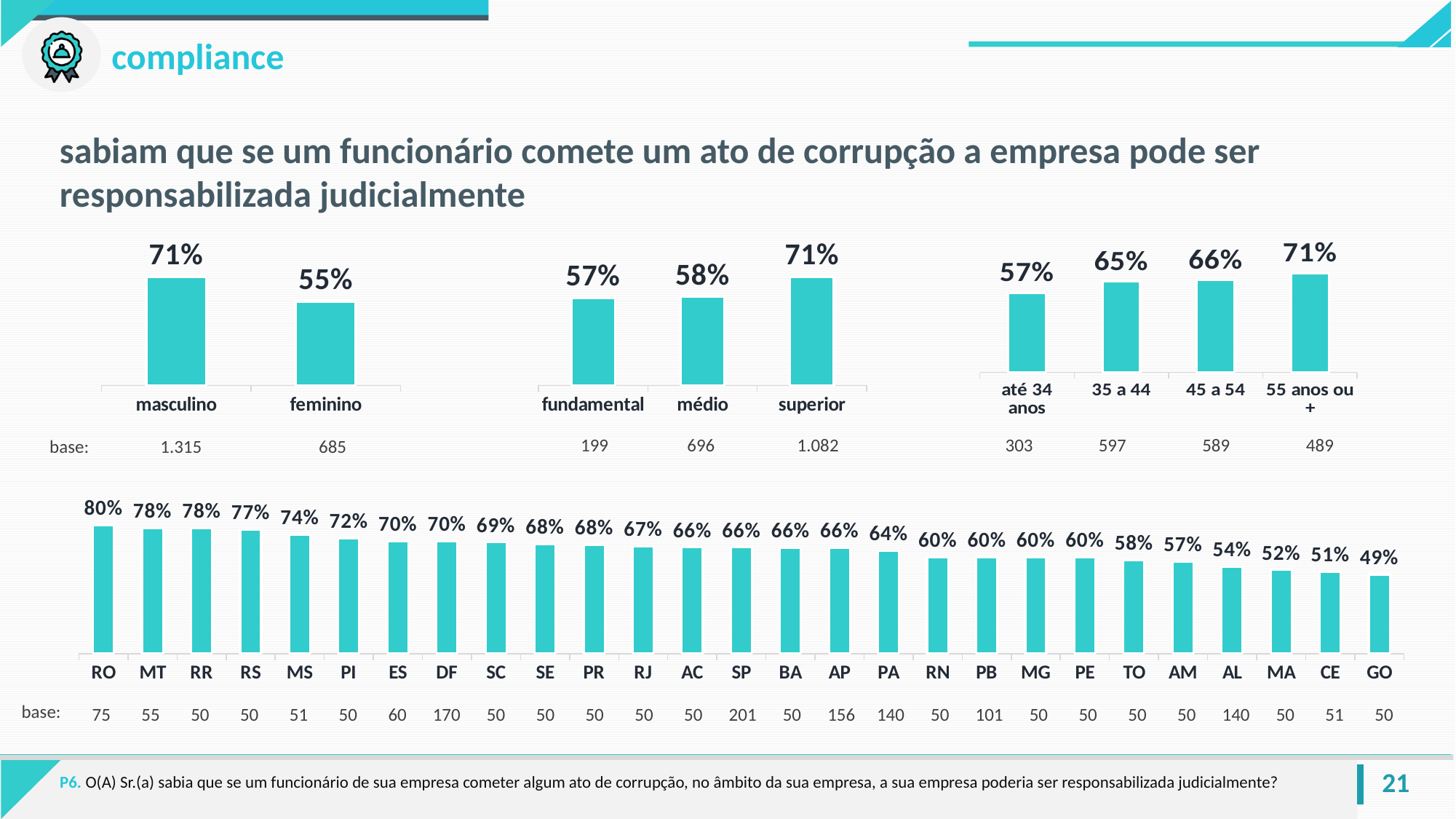
In the state chart at the bottom, which state has the highest value? RO In the state chart at the bottom, which state has the lowest value? GO In the education chart (fundamental/médio/superior), which category has the highest value? superior In the gender chart, what is the difference between masculino and feminino? 16 percentage points In the age chart, do the values rise or fall from até 34 anos to 55 anos ou +? rise What type of chart is the state chart at the bottom of the slide? bar chart In the education chart, what is the value for médio? 58% In the state chart at the bottom, what is the value for DF? 70% In the gender chart (masculino/feminino), what is the value for masculino? 71% In the state chart at the bottom, how many states are shown? 27 In the age chart, how many age categories are shown? 4 In the age chart, what is the value for 35 a 44? 65%